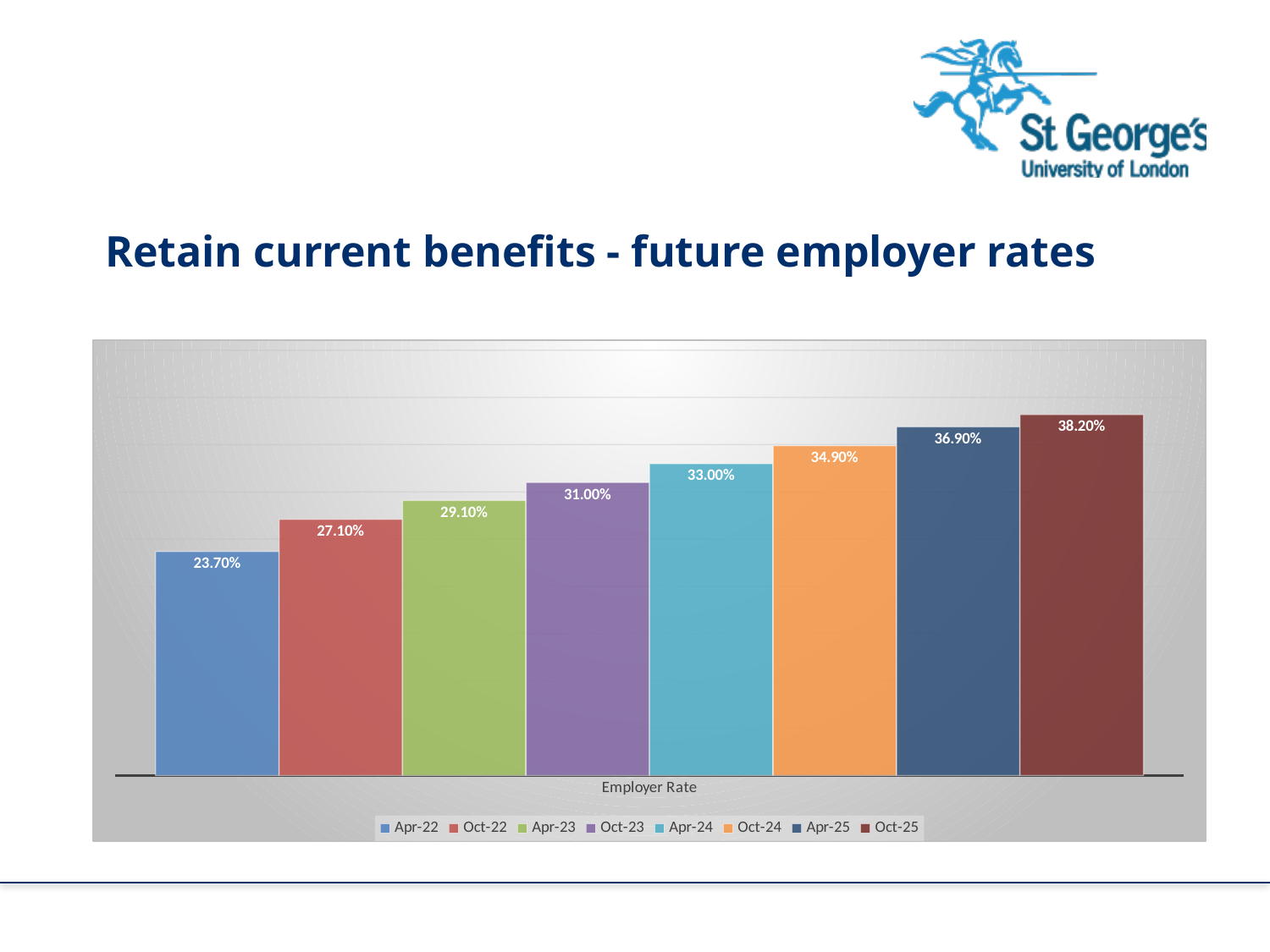
What kind of chart is shown on the slide? Bar chart What is the employer rate for Apr-22? 23.70% What is the label shown on the x axis of the chart? Employer Rate Which period has the lowest employer rate? Apr-22 Which period has the highest employer rate? Oct-25 What is the difference between the employer rate for Apr-24 and Oct-23? 2.00% How many series does the legend list? 8 What is the employer rate for Oct-24? 34.90% Do the employer rates rise or fall from Apr-22 to Oct-25? Rise What is the employer rate for Apr-25? 36.90% Which is larger, the employer rate for Oct-22 or Apr-23? Apr-23 What is the difference between the employer rate for Oct-25 and Apr-22? 14.50%